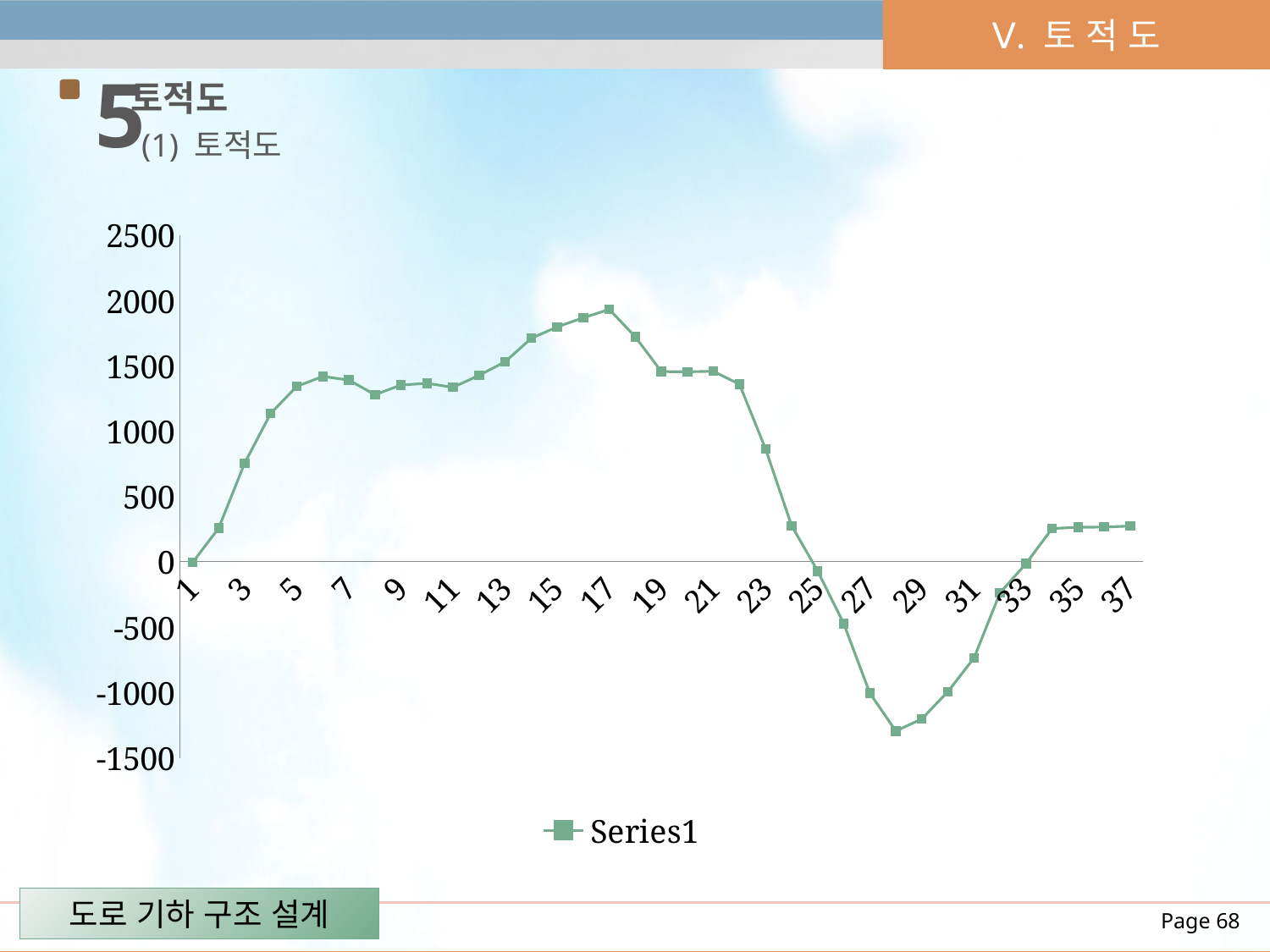
Does Series1 rise or fall between x = 17 and x = 28? fall Is the value of Series1 at x = 28 greater or less than -1000? less At which x-axis position does Series1 reach its lowest value? 28 How many series does the legend list? 1 At which x-axis position does Series1 reach its highest value? 17 What is the highest value shown on the vertical axis? 2500 What kind of chart is shown on the slide? line chart What is the name of the series shown in the legend? Series1 Which is larger, the value of Series1 at x = 5 or at x = 3? x = 5 Is the value of Series1 at x = 17 greater or less than 1500? greater Is the value of Series1 at x = 23 greater or less than 1000? less